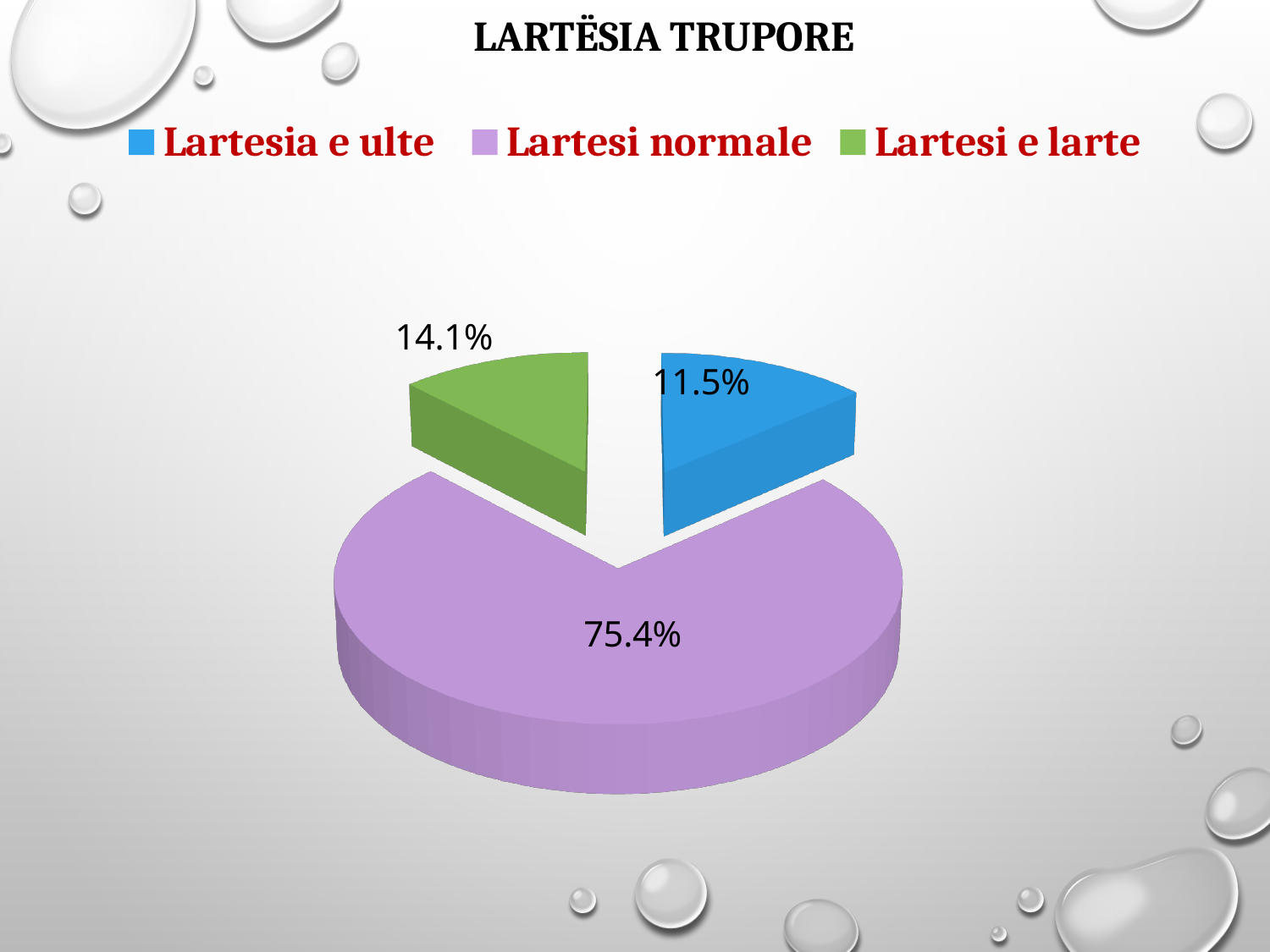
Which is larger, the value for Lartesi e larte or the value for Lartesia e ulte? Lartesi e larte How many entries does the legend list? 3 What kind of chart is shown on the slide? pie chart Which category has the smallest share of the pie? Lartesia e ulte What is the value for Lartesia e ulte? 11.5% What is the difference between the values for Lartesi normale and Lartesi e larte? 61.3% How many slices does the pie chart have? 3 What is the title of the chart? LARTËSIA TRUPORE What is the difference between the values for Lartesi e larte and Lartesia e ulte? 2.6% What is the value for Lartesi normale? 75.4% What is the value for Lartesi e larte? 14.1% Which category has the largest share of the pie? Lartesi normale